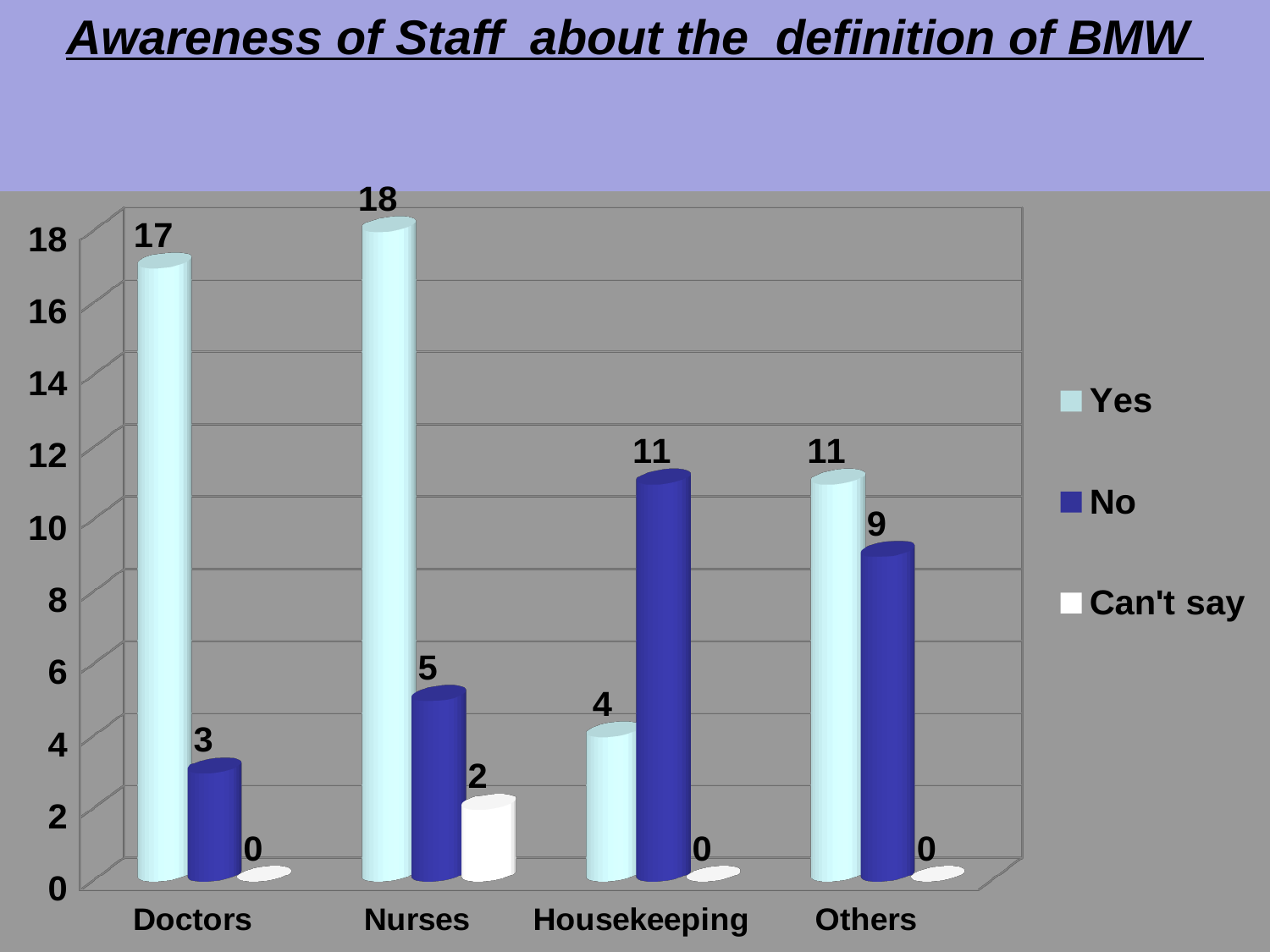
For Housekeeping, which is larger: the 'Yes' value or the 'No' value? No What is the difference between the 'Yes' and 'No' values for Doctors? 14 What kind of chart is shown on the slide? Bar chart What is the 'Yes' value for Nurses? 18 What is the 'No' value for Housekeeping? 11 Which category has the lowest 'No' value? Doctors What is the title of the chart? Awareness of Staff about the definition of BMW How many staff categories are shown on the x axis? 4 What is the 'Can't say' value for Nurses? 2 Which category has the highest 'Yes' value? Nurses What is the total of the three values for Others? 20 How many series does the legend list? 3